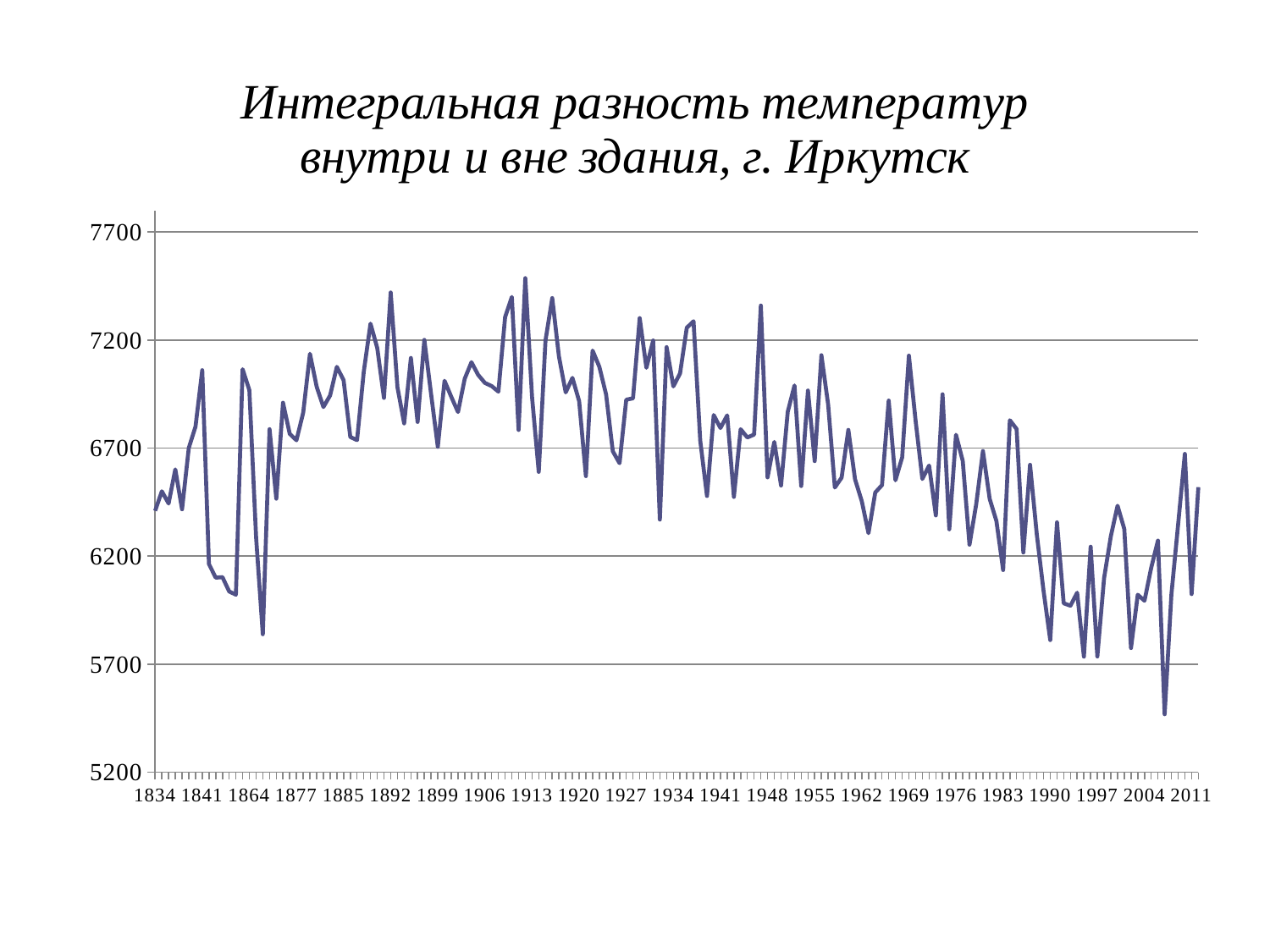
What kind of chart is shown on the slide? line chart Is the value for 1834 greater or less than 6700? less Is the value for 2011 greater or less than 6700? less Is the value for 1913 larger or smaller than the value for 1990? larger Is the lowest value on the chart greater or less than 5700? less What is the title of the chart? Интегральная разность температур внутри и вне здания, г. Иркутск Do the values generally rise or fall along the x axis from 1913 to 2011? fall What is the first year label on the x axis? 1834